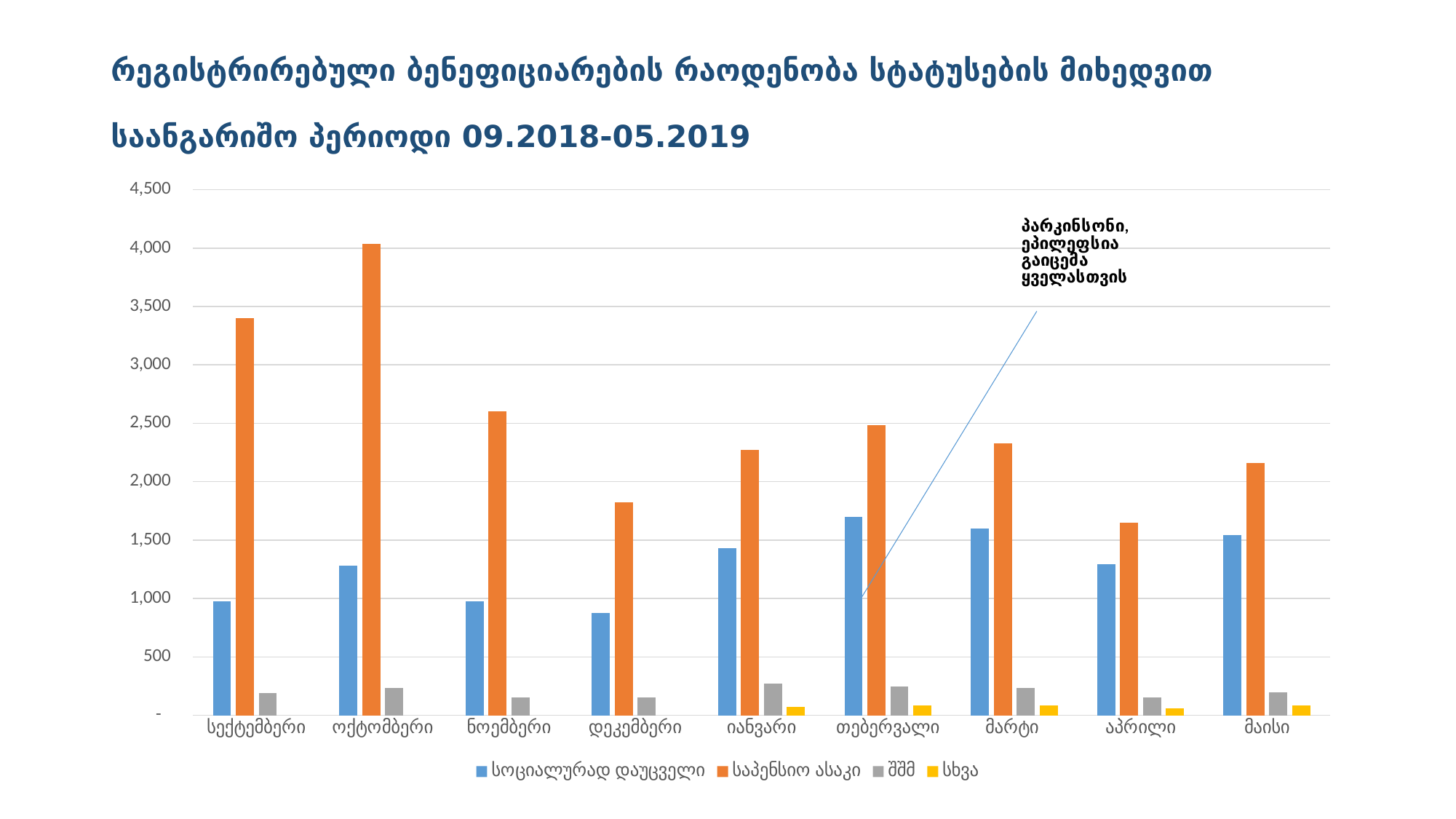
In which month is the value for საპენსიო ასაკი the lowest? აპრილი Does the value for საპენსიო ასაკი rise or fall from ოქტომბერი to დეკემბერი? fall In which month is the value for საპენსიო ასაკი the highest? ოქტომბერი Is the value for საპენსიო ასაკი in ოქტომბერი greater or less than 3,500? greater How many months are shown on the x axis of the chart? 9 Is the value for საპენსიო ასაკი in სექტემბერი greater or less than 3,000? greater In which month is the value for სოციალურად დაუცველი the lowest? დეკემბერი What colour are the bars for the series საპენსიო ასაკი? orange Is the value for სოციალურად დაუცველი in დეკემბერი greater or less than 1,000? less What kind of chart is shown on the slide? bar chart Which is larger: the value for საპენსიო ასაკი in სექტემბერი or in ნოემბერი? სექტემბერი How many series does the chart legend list? 4